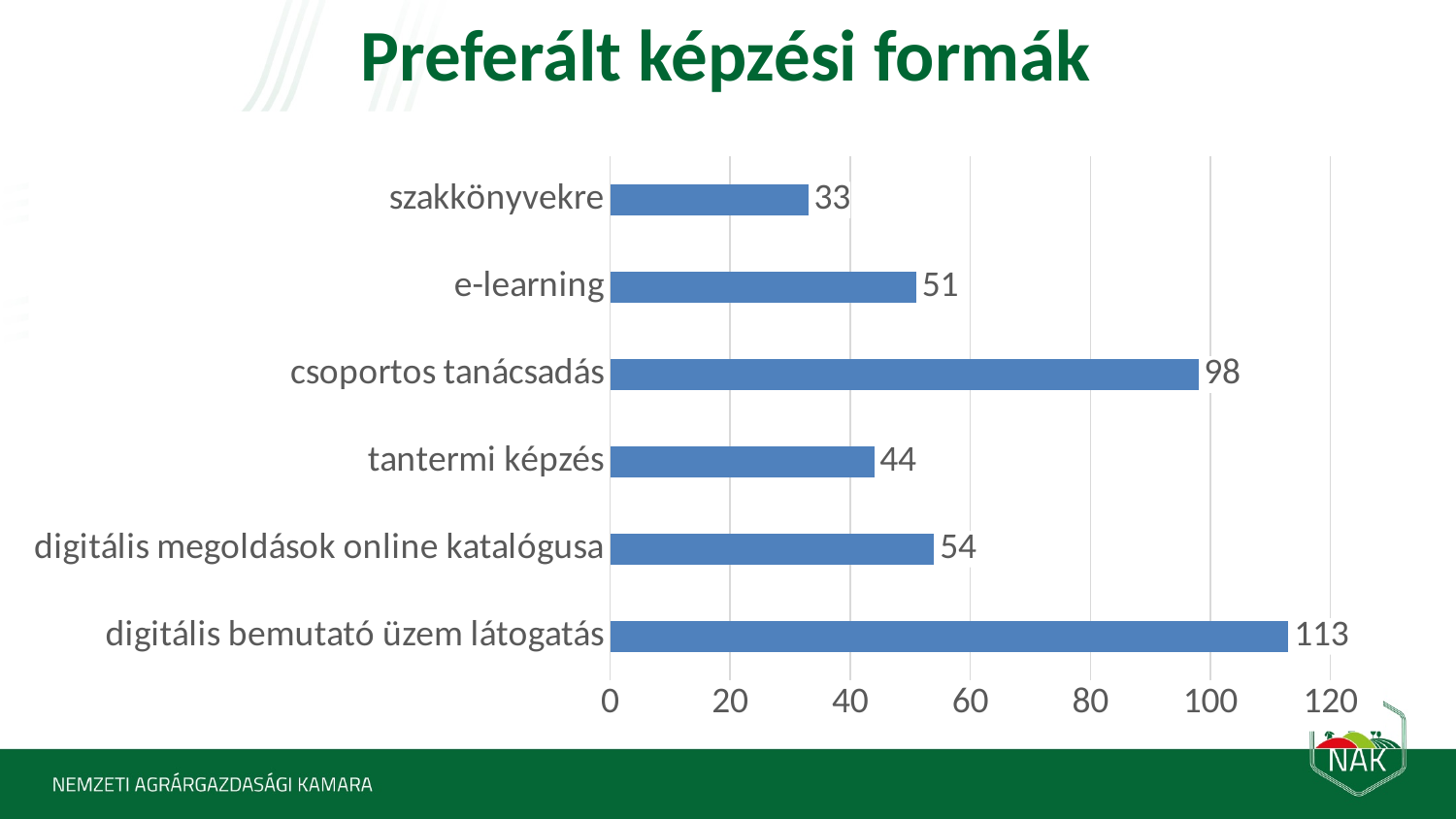
Which is larger, the value for "e-learning" or the value for "tantermi képzés"? e-learning What is the value for "digitális bemutató üzem látogatás"? 113 Which category has the lowest value? szakkönyvekre What is the difference between the values for "digitális megoldások online katalógusa" and "szakkönyvekre"? 21 Is the value for "csoportos tanácsadás" greater or less than 80? greater What is the value for "csoportos tanácsadás"? 98 What is the value for "tantermi képzés"? 44 What is the value for "e-learning"? 51 What is the difference between the values for "digitális bemutató üzem látogatás" and "csoportos tanácsadás"? 15 What type of chart is shown on the slide? bar chart Which category has the highest value? digitális bemutató üzem látogatás How many categories are shown in the chart? 6